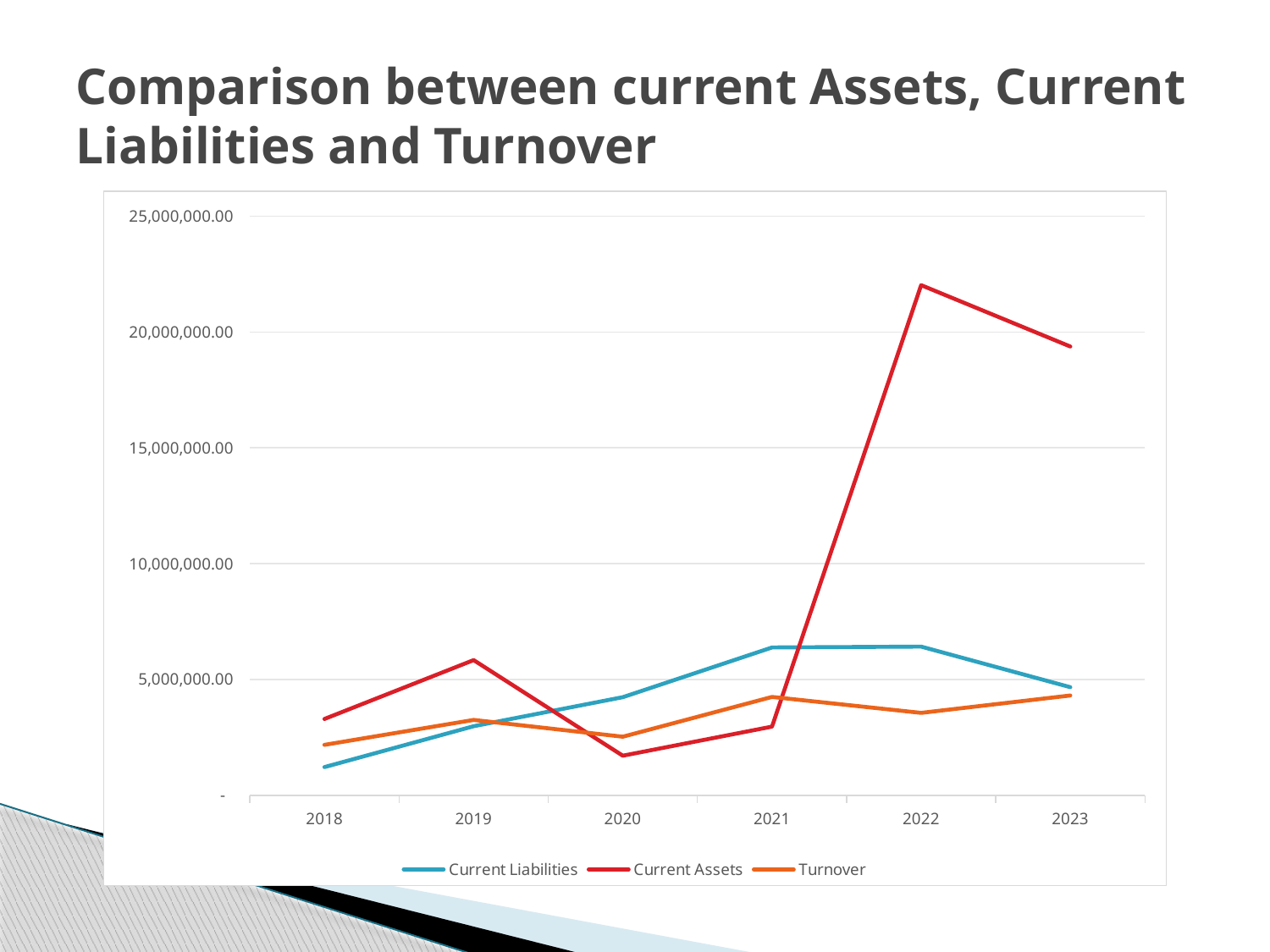
Which series is drawn in red? Current Assets Is the value for Turnover in 2018 greater or less than 5,000,000.00? less Is the value for Current Assets in 2022 greater or less than 20,000,000.00? greater Does the Current Assets line rise or fall between 2021 and 2022? Rise Does the Current Liabilities line rise or fall between 2022 and 2023? Fall Is the value for Current Liabilities in 2021 greater or less than 5,000,000.00? greater What kind of chart is shown on the slide? Line chart In 2022, which is larger: Current Assets or Current Liabilities? Current Assets How many series does the legend list? 3 How many years are shown along the x axis? 6 In which year does Current Assets reach its highest value? 2022 In which year is Current Assets at its lowest value? 2020